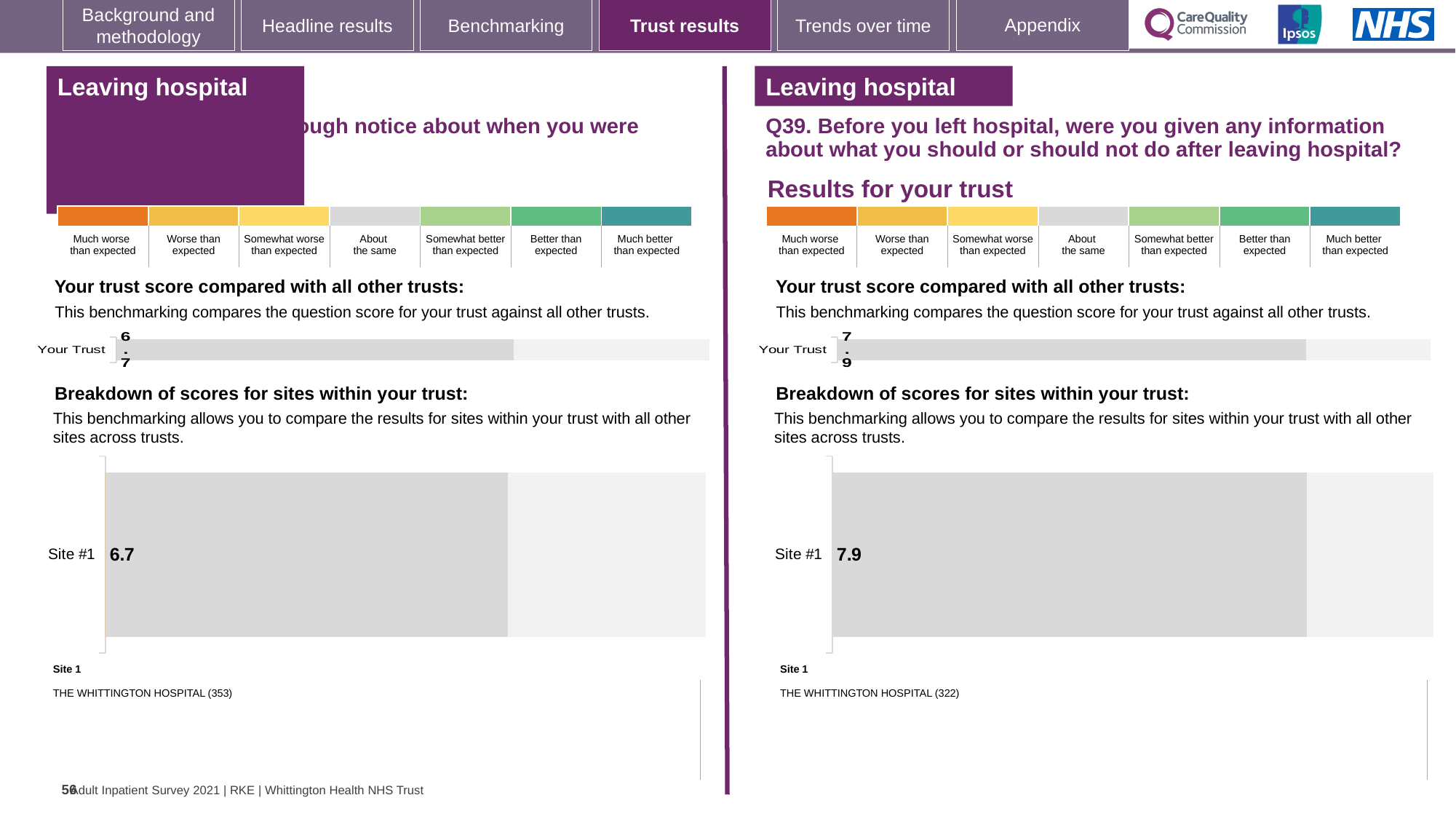
On the right-hand side of the slide (Q39), what is the score shown for Site #1 in the 'Breakdown of scores for sites within your trust' chart? 7.9 On the right-hand side (Q39), which site is listed as Site 1 below the breakdown chart? THE WHITTINGTON HOSPITAL (322) Which is larger: the Site #1 score in the left-hand breakdown chart or the Site #1 score in the right-hand (Q39) breakdown chart? The right-hand (Q39) chart On the right-hand side of the slide (Q39), what is the score shown for Your Trust in the 'Your trust score compared with all other trusts' chart? 7.9 What kind of chart is used to show the Site #1 score in the 'Breakdown of scores for sites within your trust' section on the right-hand side (Q39)? Bar chart On the left-hand side of the slide, what is the score shown for Your Trust in the 'Your trust score compared with all other trusts' chart? 6.7 What is the difference between the Your Trust score on the right-hand side (Q39) and the Your Trust score on the left-hand side of the slide? 1.2 How many sites are plotted in the 'Breakdown of scores for sites within your trust' chart on the left-hand side of the slide? 1 Is the Site #1 score in the right-hand (Q39) breakdown chart the same as the Your Trust score in the right-hand 'Your trust score compared with all other trusts' chart? Yes, both are 7.9 On the left-hand side of the slide, what is the score shown for Site #1 in the 'Breakdown of scores for sites within your trust' chart? 6.7 On the left-hand side of the slide, which site is listed as Site 1 below the breakdown chart? THE WHITTINGTON HOSPITAL (353) How many sites are plotted in the 'Breakdown of scores for sites within your trust' chart on the right-hand side (Q39)? 1